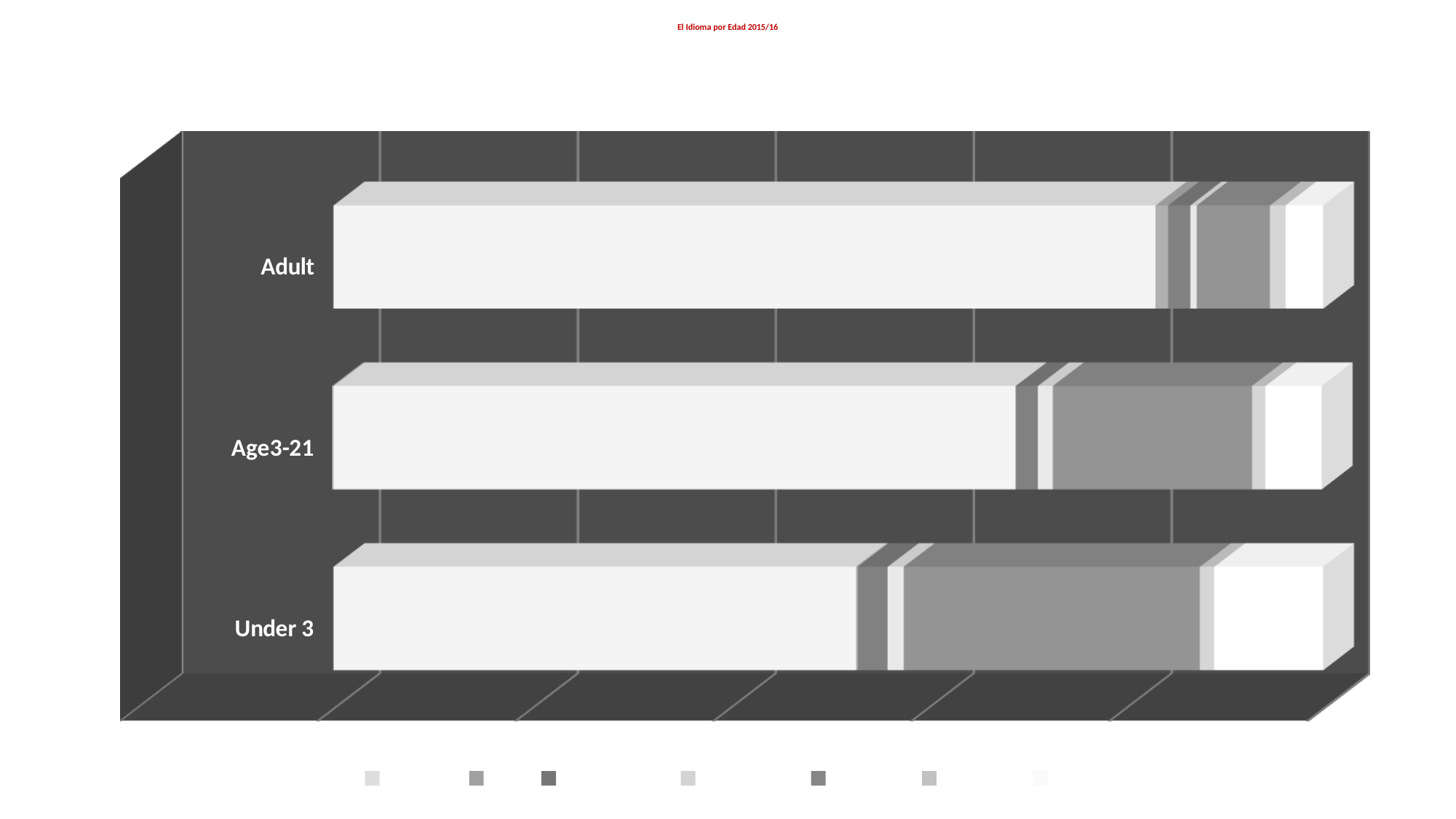
What kind of chart is shown on the slide? Stacked bar chart Is the leftmost segment of the bar longer for Age3-21 or for Under 3? Age3-21 Which category has the shortest leftmost (lightest) segment in its bar? Under 3 How many series entries does the legend show? 7 Which category has the longest leftmost (lightest) segment in its bar? Adult Which category is listed at the top of the chart? Adult How many categories are shown on the chart's vertical axis? 3 What is the title of the chart? El Idioma por Edad 2015/16